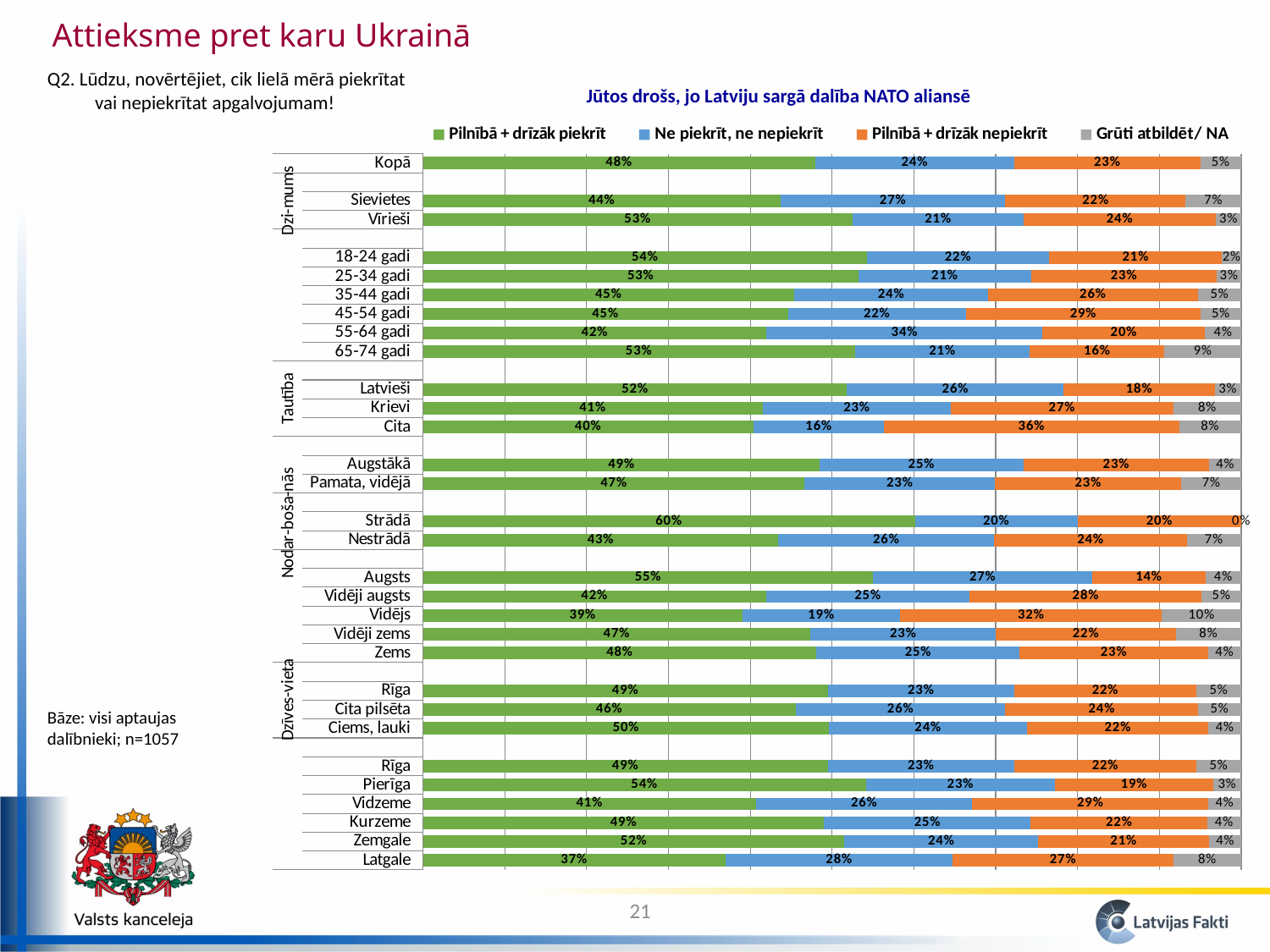
What is the value of "Pilnībā + drīzāk nepiekrīt" for Cita? 36% What is the title of the chart? Jūtos drošs, jo Latviju sargā dalība NATO aliansē What is the difference between the "Pilnībā + drīzāk piekrīt" values for Vīrieši and Sievietes? 9% Which has a larger "Pilnībā + drīzāk nepiekrīt" value, Latvieši or Krievi? Krievi What kind of chart is shown on the slide? Stacked bar chart What is the value of "Grūti atbildēt/ NA" for Vidējs? 10% How many series does the legend list? 4 Which category has the highest value of "Pilnībā + drīzāk piekrīt"? Strādā What is the value of "Ne piekrīt, ne nepiekrīt" for 55-64 gadi? 34% What is the value of "Grūti atbildēt/ NA" for Strādā? 0% What is the value of "Pilnībā + drīzāk piekrīt" for Kopā? 48% Which category has the lowest value of "Pilnībā + drīzāk piekrīt"? Latgale